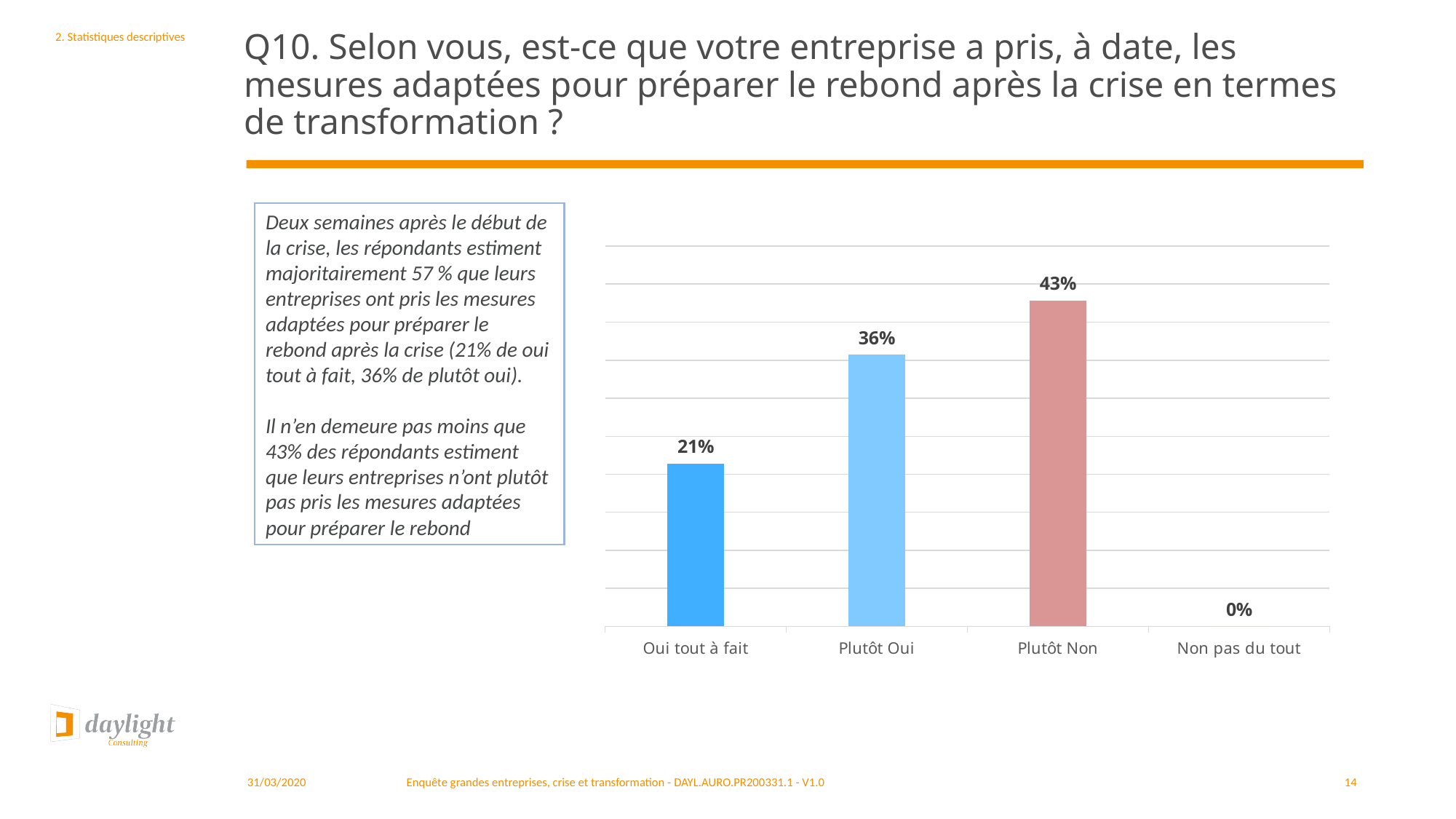
What is the value for "Non pas du tout"? 0% What kind of chart is shown on the slide? Bar chart How many categories are shown on the x axis? 4 What is the difference between the values for "Plutôt Non" and "Plutôt Oui"? 7% What is the value for "Plutôt Non"? 43% Which category has the highest value? Plutôt Non What colour is the bar for "Plutôt Non"? Pinkish red What is the value for "Plutôt Oui"? 36% Which category has the lowest value? Non pas du tout What is the difference between the values for "Plutôt Oui" and "Oui tout à fait"? 15% Which is larger, the value for "Oui tout à fait" or the value for "Plutôt Oui"? Plutôt Oui What is the value for "Oui tout à fait"? 21%